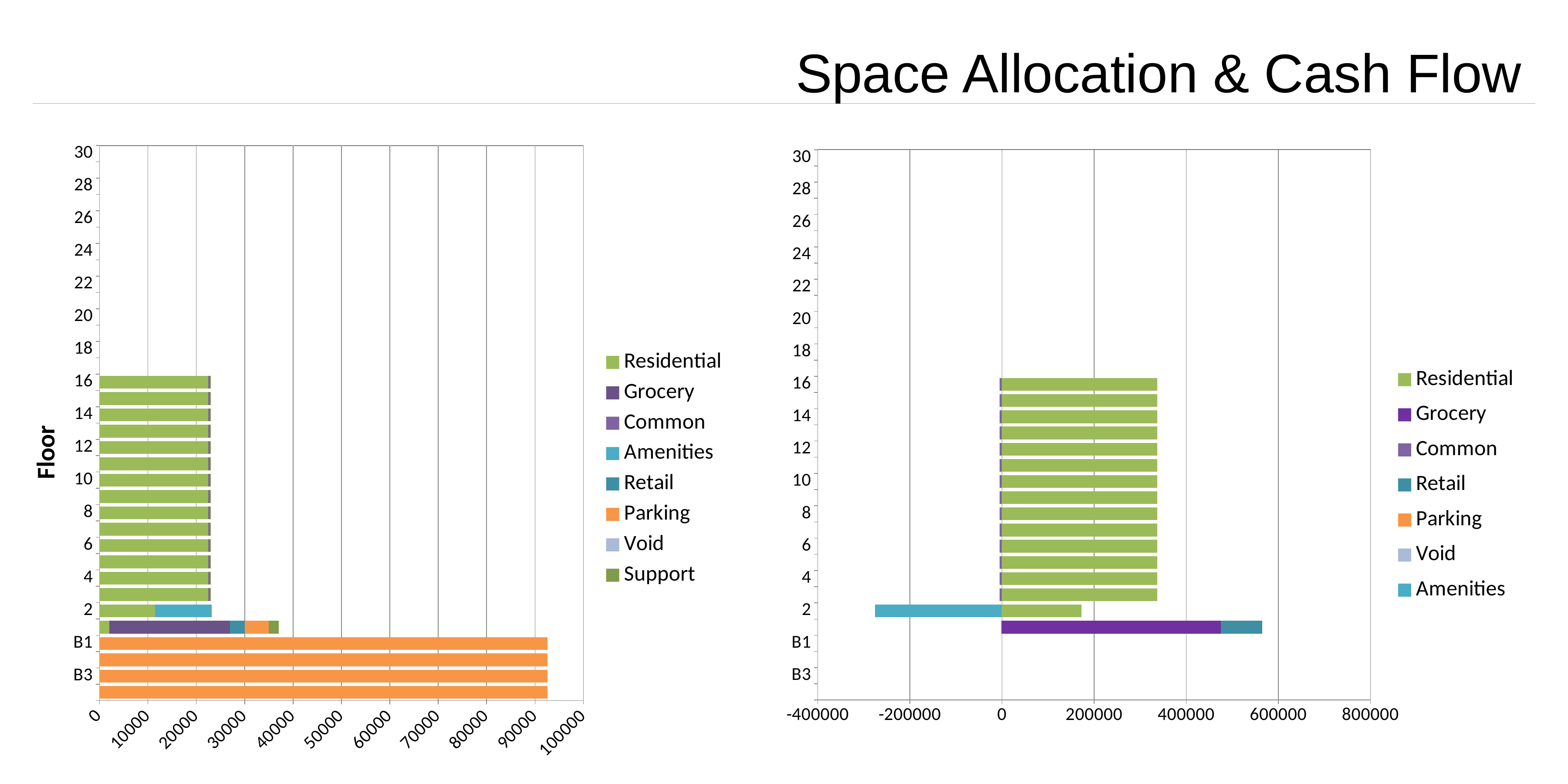
In the right chart, which floor has the largest positive stacked total? 1 In the right chart, is the Grocery value for floor 1 greater or less than 400000? greater In the left chart, is the Residential value for floor 16 greater or less than 30000? less What is the title of the slide containing the two charts? Space Allocation & Cash Flow How many series does the legend of the left chart list? 8 In the right chart, is the Residential value for floor 16 greater or less than 200000? greater What is the vertical axis title of the left chart? Floor How many series does the legend of the right chart list? 7 What kind of chart is the right chart on the slide? bar chart What kind of chart is the left chart on the slide? bar chart